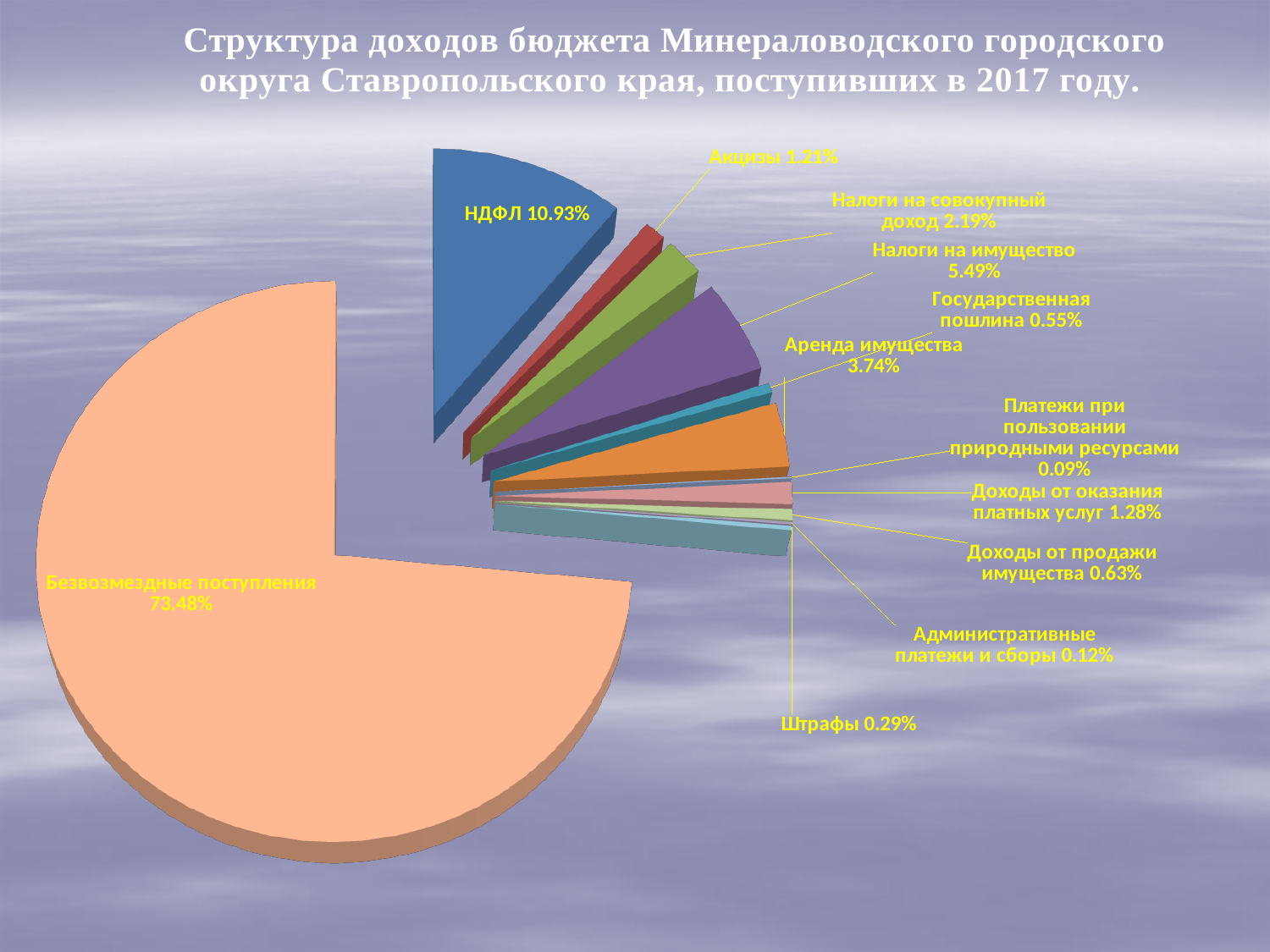
Which category has the smallest slice of the pie? Платежи при пользовании природными ресурсами How many slices does the pie chart have? 12 What is the difference between the shares of НДФЛ and Налоги на имущество? 5.44% Which is larger: Аренда имущества or Налоги на совокупный доход? Аренда имущества What kind of chart is shown on the slide? Pie chart What is the combined share of Акцизы and Доходы от оказания платных услуг? 2.49% What is the value shown for Налоги на имущество? 5.49% What is the value shown for НДФЛ? 10.93% What is the value shown for Штрафы? 0.29% What share of budget revenue is labelled for Безвозмездные поступления? 73.48% Which category has the largest slice of the pie? Безвозмездные поступления What year does the chart title say the budget revenues were received? 2017